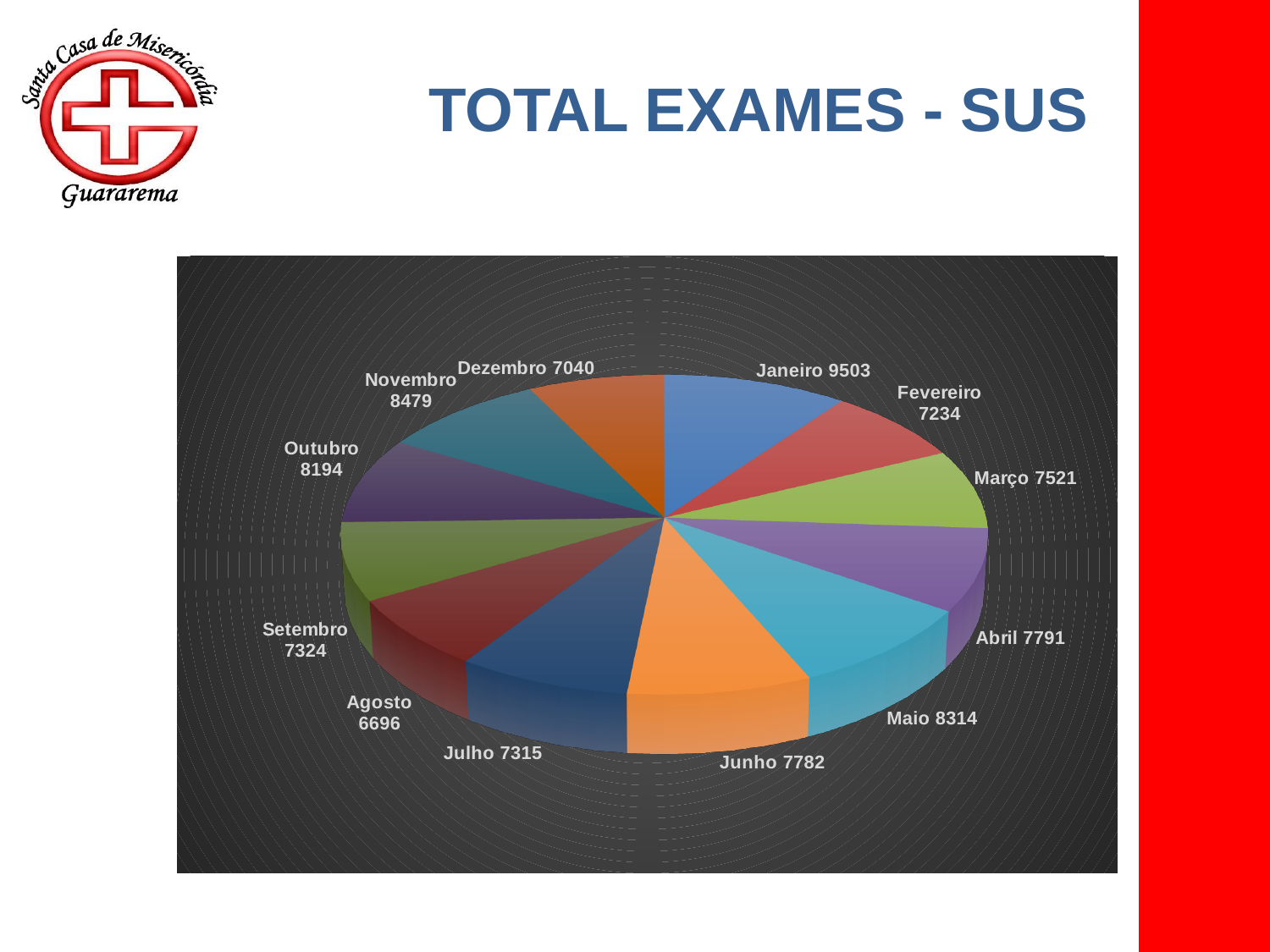
Which is larger, the value for Novembro or the value for Outubro? Novembro Which month has the highest value in the pie chart? Janeiro What is the difference between the values for Janeiro and Agosto? 2807 Which is larger, the value for Março or the value for Fevereiro? Março What is the value for Outubro in the pie chart? 8194 What kind of chart is shown on the slide? Pie chart How many slices does the pie chart have? 12 What is the difference between the values for Maio and Abril? 523 What is the value for Janeiro in the pie chart? 9503 What is the title of the slide containing the chart? TOTAL EXAMES - SUS What is the value for Agosto in the pie chart? 6696 Which month has the lowest value in the pie chart? Agosto